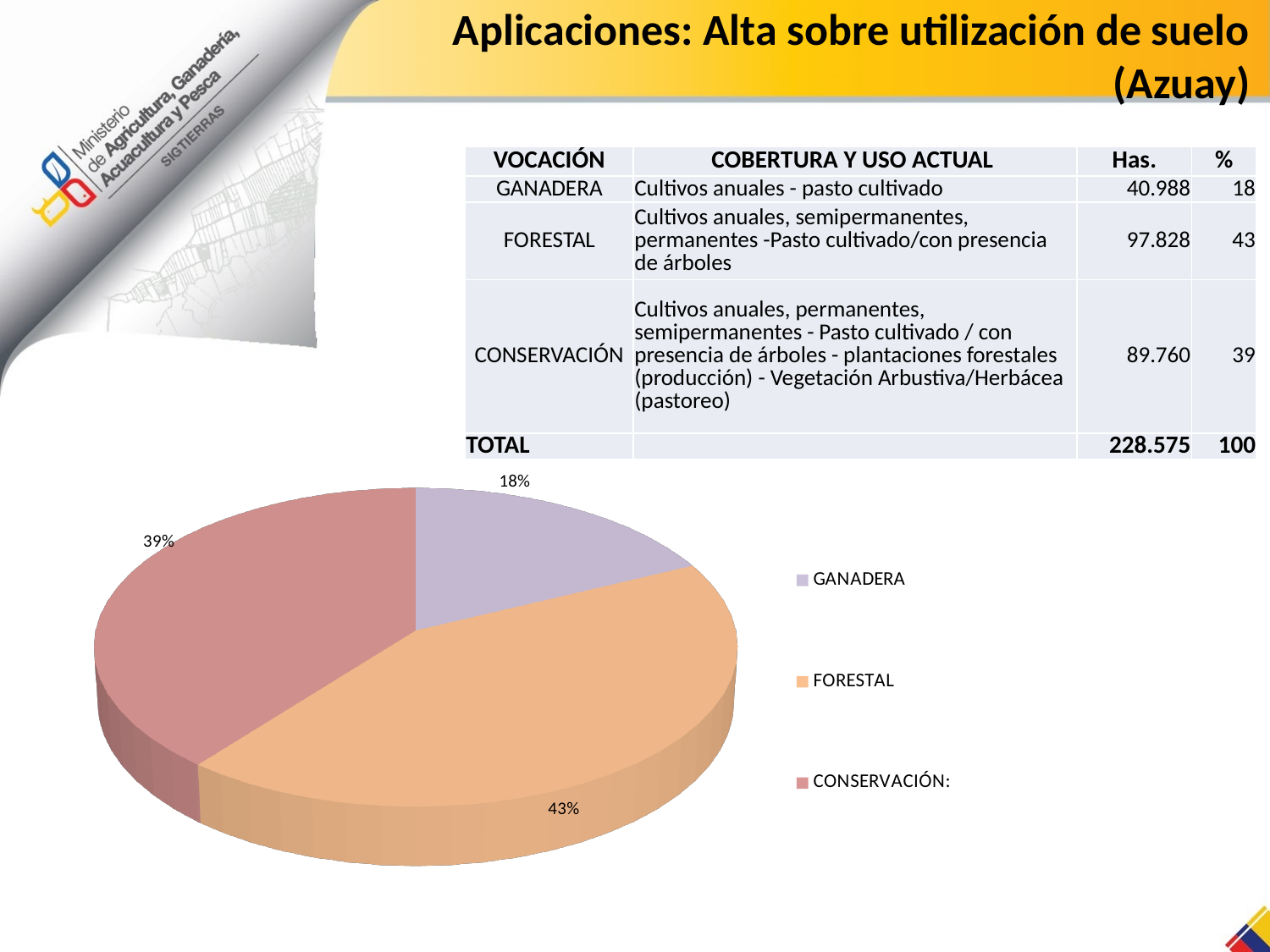
What is the difference in percentage points between the FORESTAL and CONSERVACIÓN slices? 4 How many slices does the pie chart have? 3 How many entries does the legend list? 3 What share of the pie does CONSERVACIÓN represent? 39% Which legend entry is shown in the light purple colour? GANADERA What share of the pie does FORESTAL represent? 43% Which category has the smallest slice of the pie? GANADERA What is the difference in percentage points between the FORESTAL and GANADERA slices? 25 Which category has the largest slice of the pie? FORESTAL What share of the pie does GANADERA represent? 18% Which slice is larger, CONSERVACIÓN or GANADERA? CONSERVACIÓN What kind of chart is shown on the slide? Pie chart